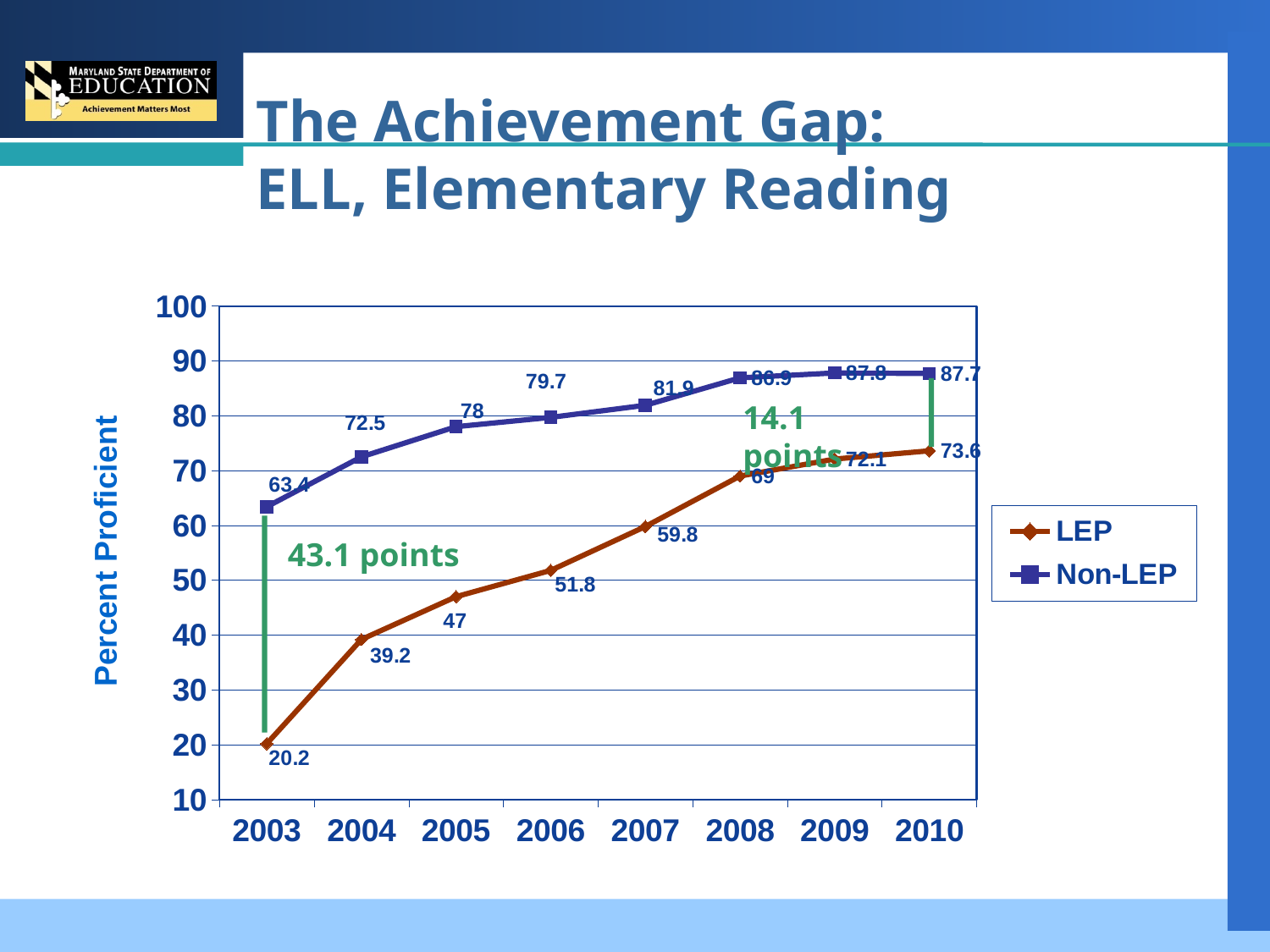
How many years are plotted on the x axis? 8 Which is larger in 2004, the LEP value or the Non-LEP value? Non-LEP What is the LEP value for 2003? 20.2 What is the LEP value for 2007? 59.8 Does the LEP series rise or fall from 2003 to 2010? rise What type of chart is shown on the slide? line chart In which year is the LEP value highest? 2010 What is the difference between the Non-LEP and LEP values in 2010? 14.1 What is the Non-LEP value for 2005? 78 In which year is the LEP value lowest? 2003 What is the Non-LEP value for 2010? 87.7 How many series does the legend list? 2